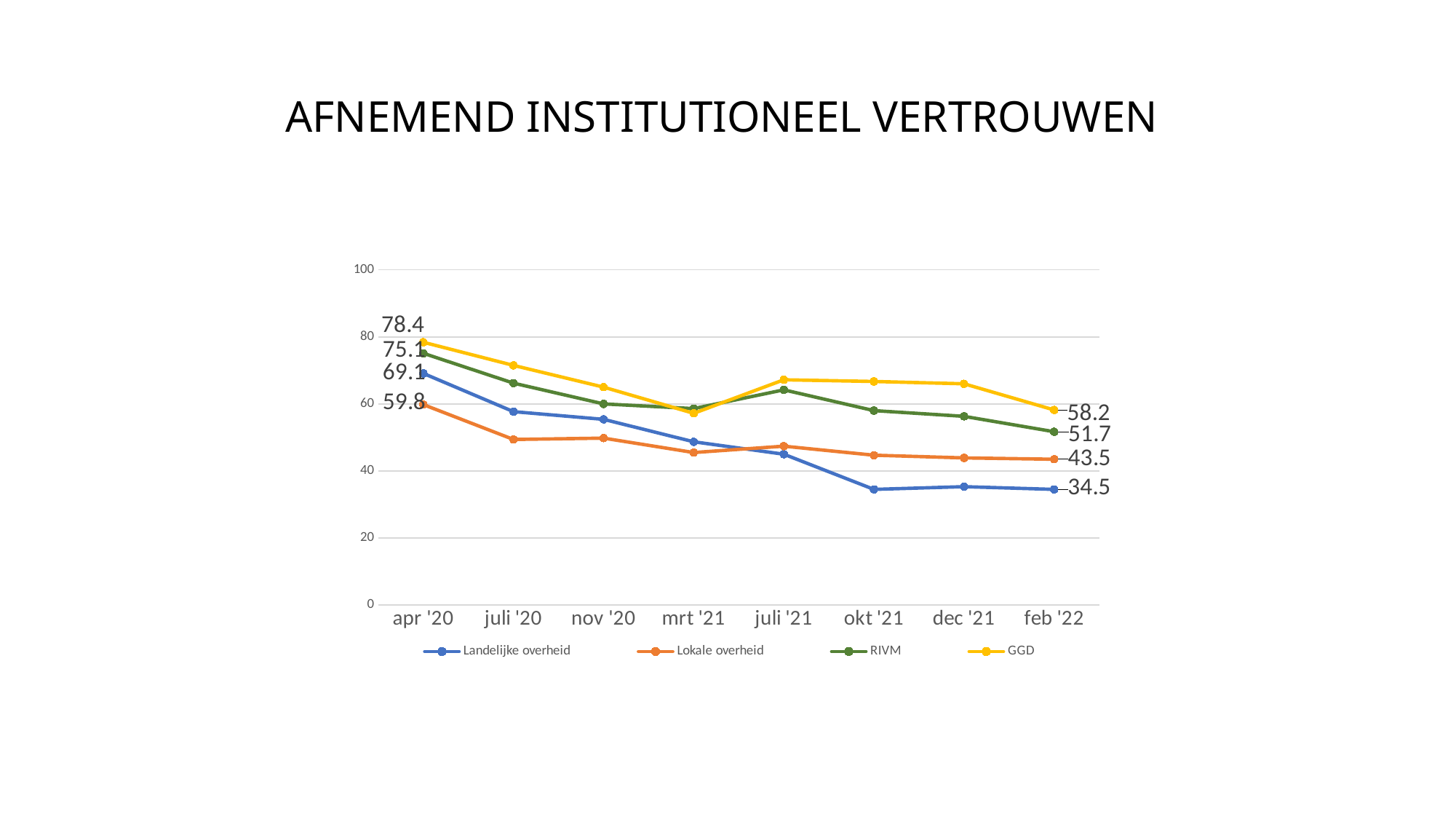
Which series has the lowest value in apr '20? Lokale overheid By how much did the value for Landelijke overheid fall from apr '20 to feb '22? 34.6 What kind of chart is shown on the slide? line chart Is the value for Landelijke overheid in okt '21 greater or less than 40? less What is the value for Landelijke overheid in feb '22? 34.5 What is the value for GGD in apr '20? 78.4 How many series does the legend list? 4 What is the value for RIVM in feb '22? 51.7 Does the value for Landelijke overheid rise or fall from apr '20 to feb '22? fall How many time points are shown on the x axis? 8 What is the value for Lokale overheid in apr '20? 59.8 Which series has the highest value in feb '22? GGD